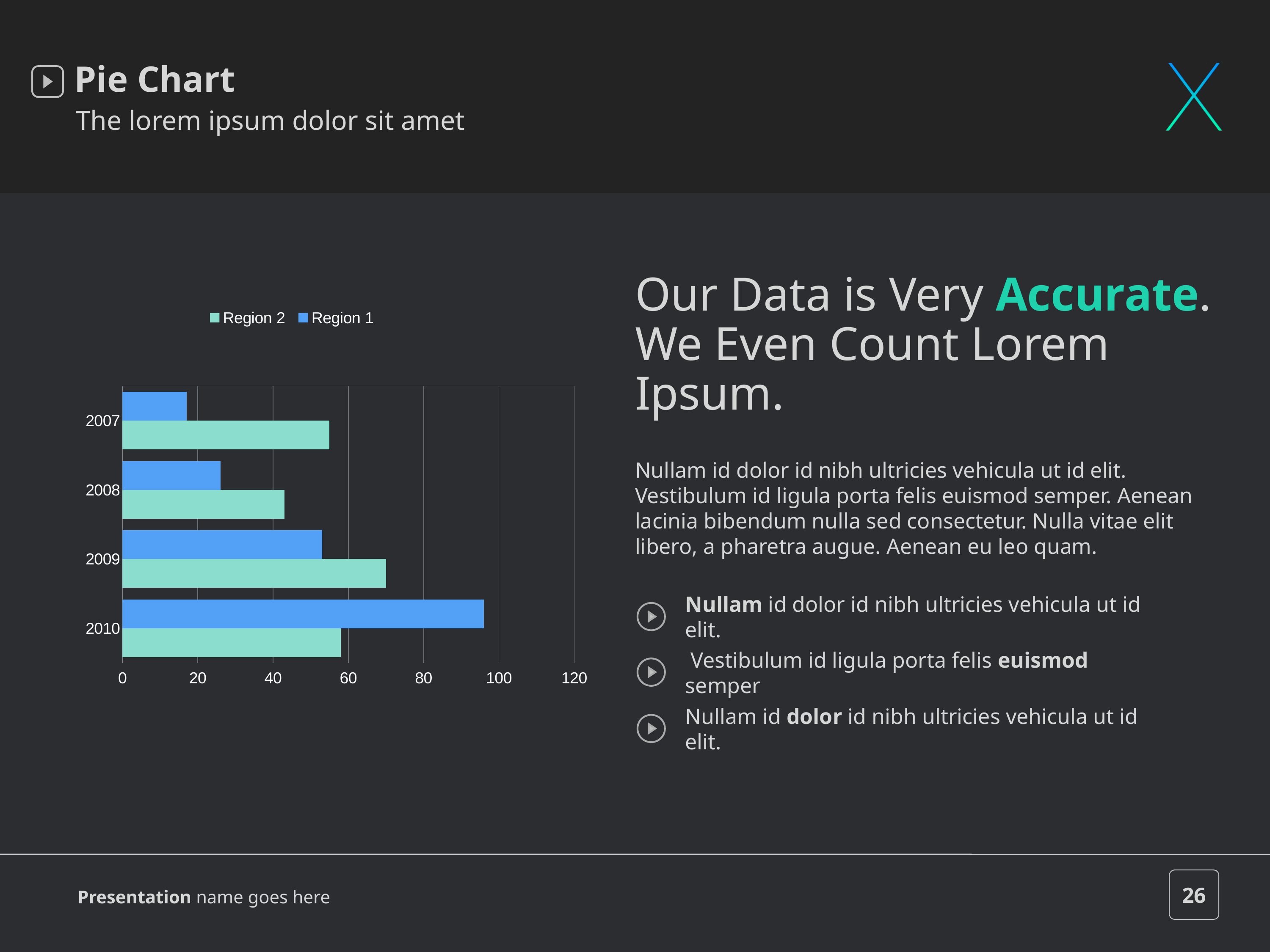
What kind of chart is shown on the slide? bar chart Which year has the highest value for Region 2? 2009 Which year has the lowest value for Region 2? 2008 What are the names of the two series in the legend? Region 2 and Region 1 How many series does the chart's legend list? 2 In 2010, which series has the larger value, Region 1 or Region 2? Region 1 Is the value for Region 1 in 2010 greater or less than 80? greater How many years are shown on the chart's category axis? 4 Do the Region 1 values rise or fall from 2007 to 2010? rise Which year has the highest value for Region 1? 2010 In 2007, which series has the larger value, Region 1 or Region 2? Region 2 Which year has the lowest value for Region 1? 2007